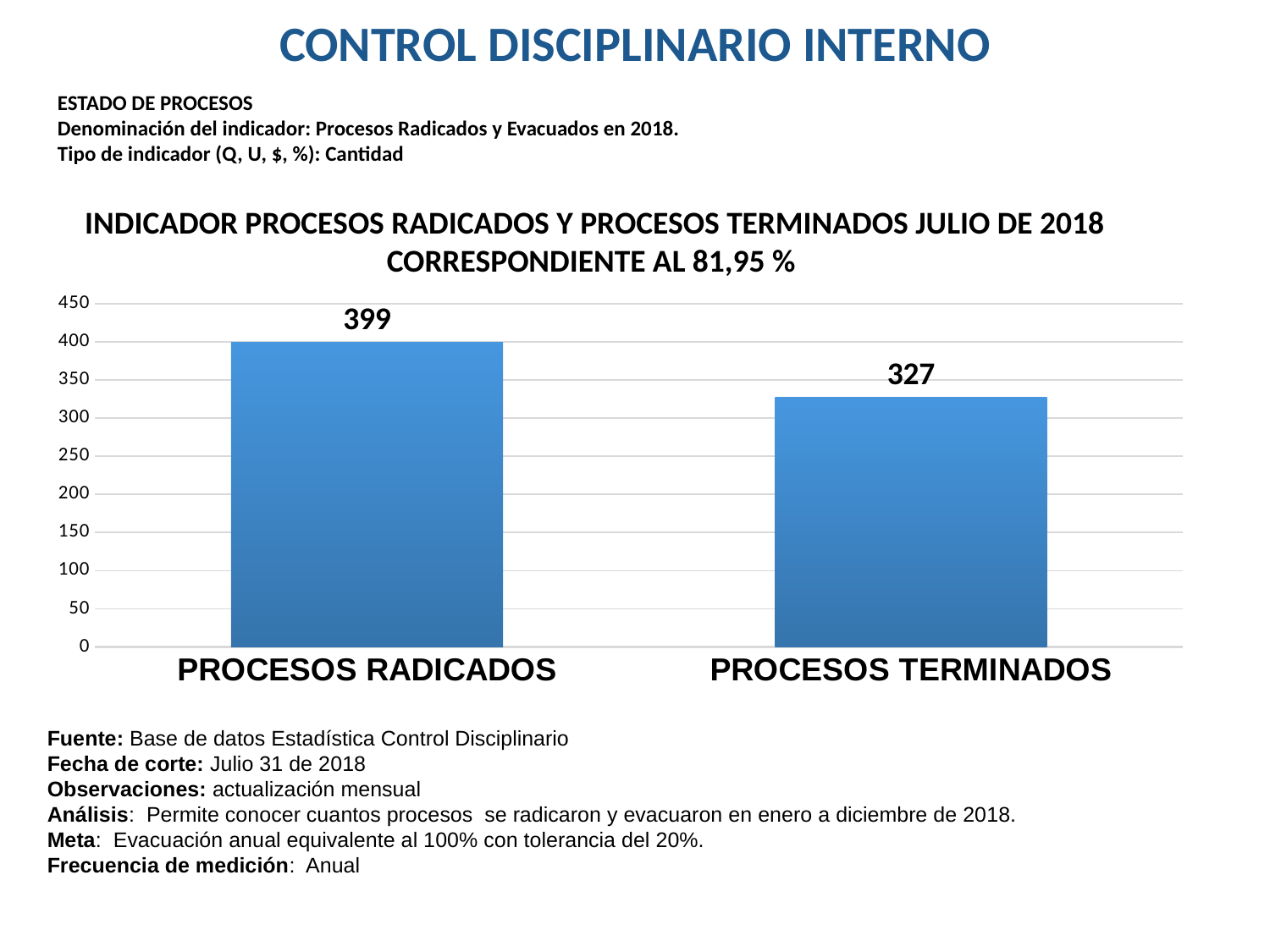
Which category has the highest value? PROCESOS RADICADOS What is the difference between PROCESOS RADICADOS and PROCESOS TERMINADOS? 72 What is the value for PROCESOS RADICADOS? 399 What is the maximum value shown on the vertical axis? 450 What is the value for PROCESOS TERMINADOS? 327 How many categories are shown in the chart? 2 Is the value for PROCESOS RADICADOS greater or less than 350? greater What kind of chart is shown on the slide? bar chart What percentage is stated in the chart title? 81,95 % Which is larger, PROCESOS RADICADOS or PROCESOS TERMINADOS? PROCESOS RADICADOS Which category has the lowest value? PROCESOS TERMINADOS Is the value for PROCESOS TERMINADOS greater or less than 350? less